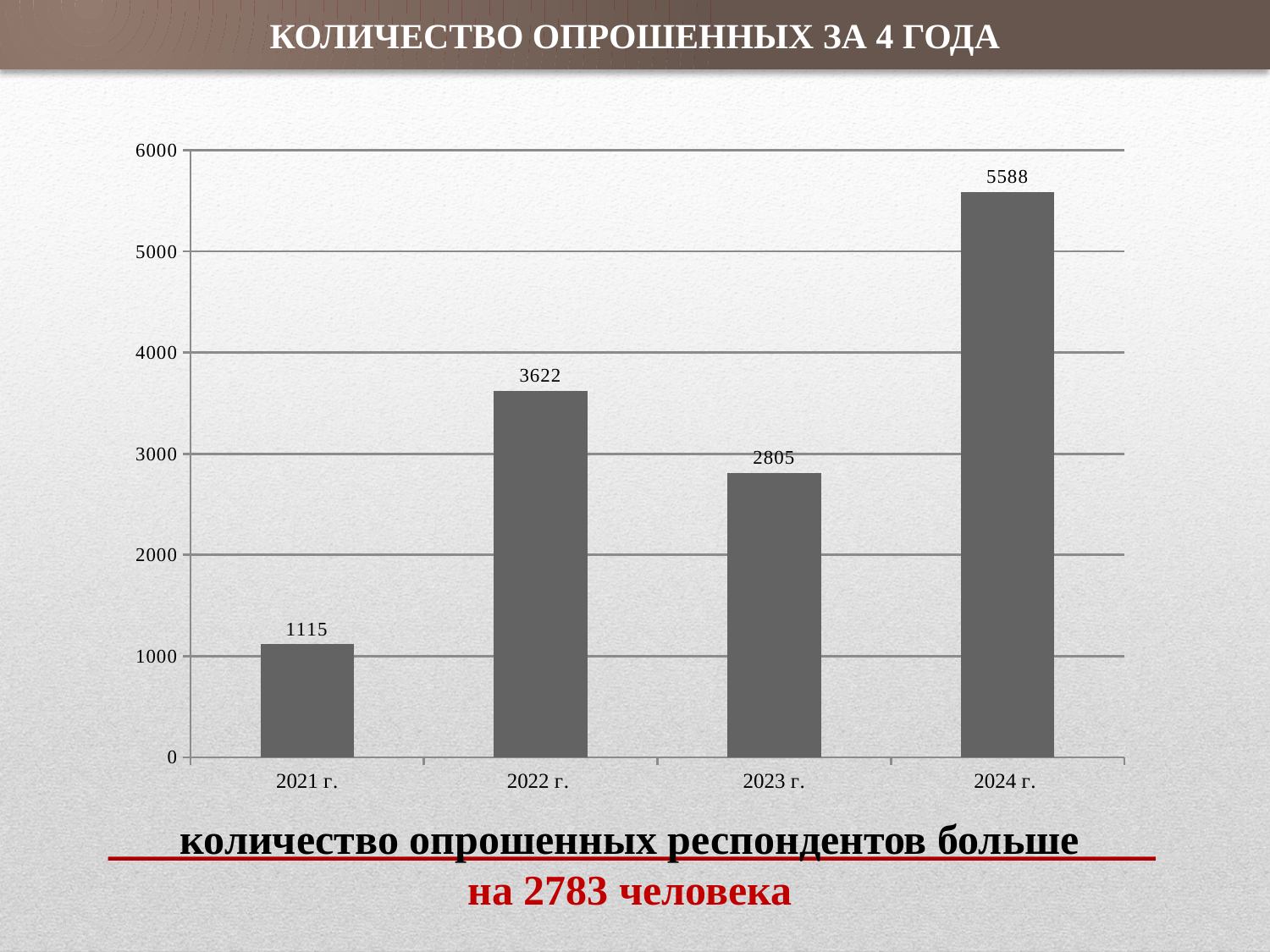
Which year has the lowest number of respondents? 2021 г. What is the value shown for 2021 г.? 1115 What is the title of the slide? КОЛИЧЕСТВО ОПРОШЕННЫХ ЗА 4 ГОДА Is the value for 2023 г. greater or less than 3000? less Which year has the highest number of respondents? 2024 г. Which is larger, the value for 2022 г. or the value for 2023 г.? 2022 г. What is the number of respondents surveyed in 2022 г.? 3622 What is the difference between the values for 2024 г. and 2023 г.? 2783 How many years are shown on the x axis? 4 What is the difference between the values for 2022 г. and 2021 г.? 2507 What is the value shown for 2024 г.? 5588 What kind of chart is shown on the slide? bar chart